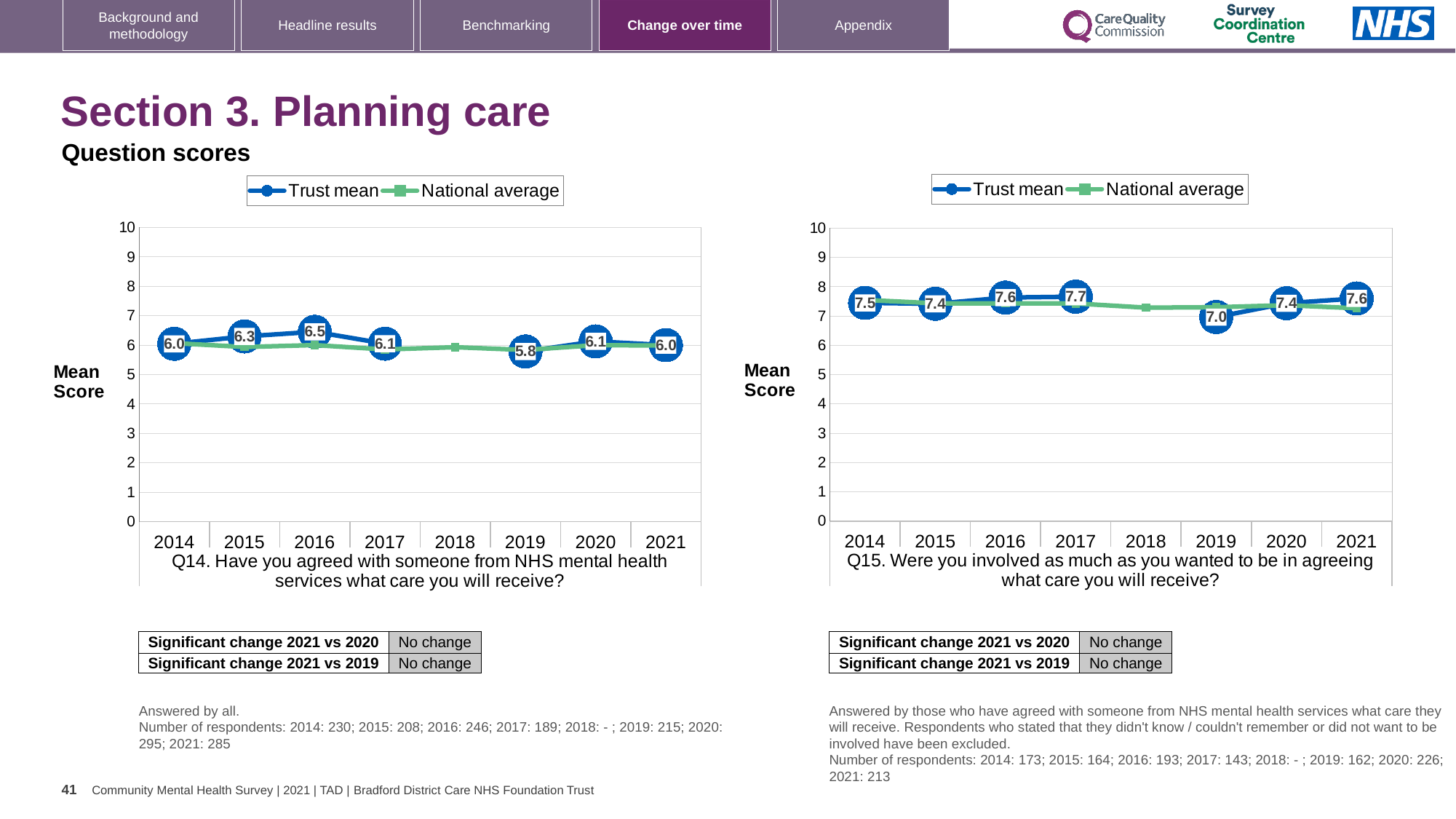
In the Q15 chart on the right, which year has the highest Trust mean? 2017 In the Q14 chart on the left, which year has the highest Trust mean? 2016 In the Q14 chart on the left, is the Trust mean for 2015 or for 2019 larger? 2015 How many series does the legend of the Q15 chart on the right list? 2 In the Q14 chart on the left, what is the Trust mean for 2021? 6.0 In the Q14 chart on the left, which year has the lowest Trust mean? 2019 What kind of chart is the Q14 chart on the left? Line chart In the Q15 chart on the right, what is the difference between the Trust mean in 2017 and in 2019? 0.7 In the Q14 chart on the left, what is the Trust mean for 2016? 6.5 In the Q15 chart on the right, is the National average for 2018 greater or less than 6? greater In the Q15 chart on the right, what is the Trust mean for 2019? 7.0 How many years are shown on the x axis of the Q14 chart on the left? 8